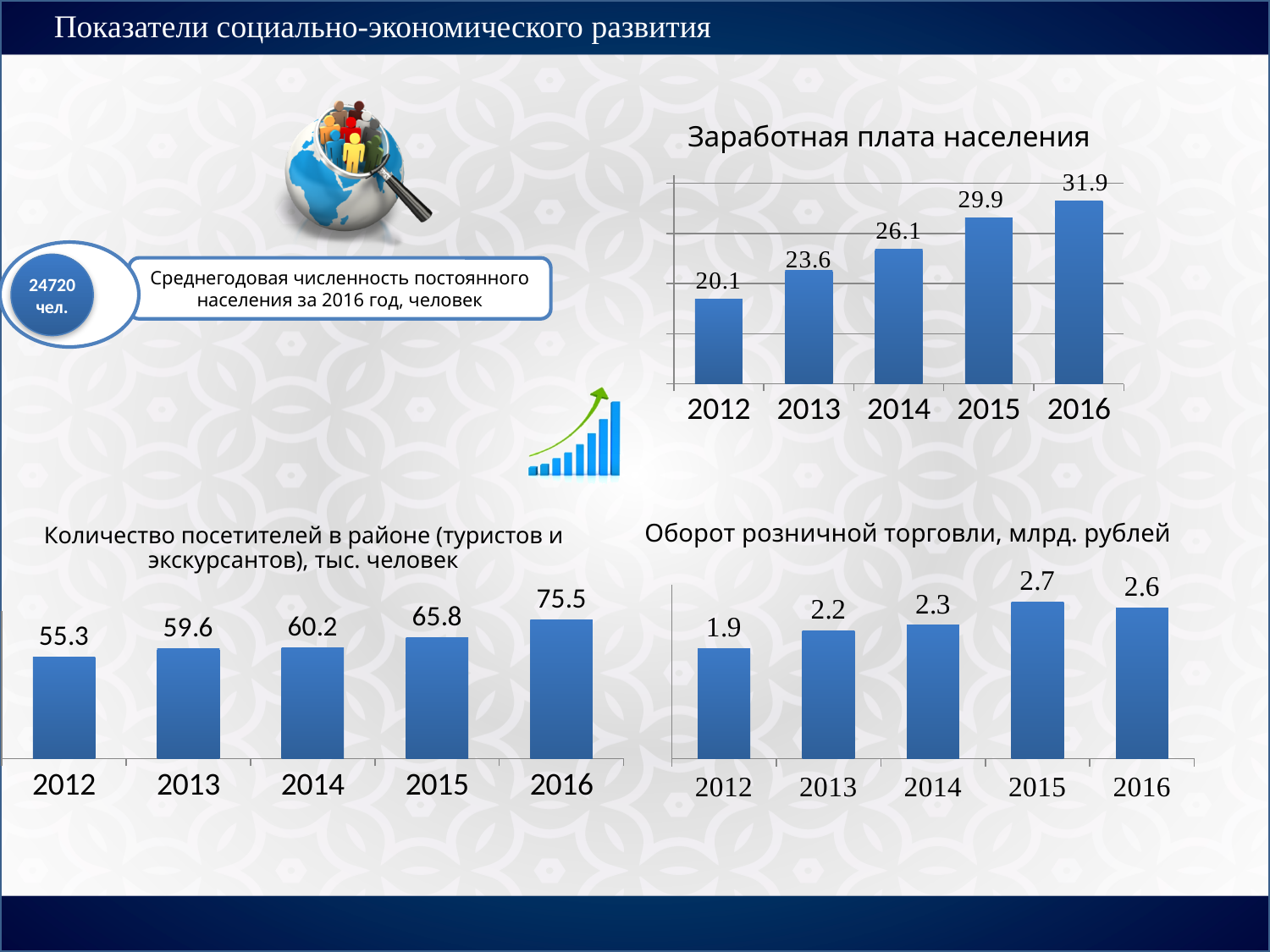
In the chart titled "Количество посетителей в районе (туристов и экскурсантов), тыс. человек", which year has the lowest value? 2012 In the chart titled "Оборот розничной торговли, млрд. рублей", which year has the highest value? 2015 In the chart titled "Количество посетителей в районе (туристов и экскурсантов), тыс. человек", what is the value for 2015? 65.8 In the chart titled "Оборот розничной торговли, млрд. рублей", which is larger, the value for 2015 or the value for 2016? 2015 In the chart titled "Заработная плата населения", what is the difference between the 2016 and 2012 values? 11.8 In the chart titled "Заработная плата населения", what is the value for 2014? 26.1 In the chart titled "Оборот розничной торговли, млрд. рублей", what is the value for 2013? 2.2 In the chart titled "Заработная плата населения", which year has the highest value? 2016 In the chart titled "Количество посетителей в районе (туристов и экскурсантов), тыс. человек", how many years are shown? 5 In the chart titled "Количество посетителей в районе (туристов и экскурсантов), тыс. человек", what is the difference between the 2016 and 2015 values? 9.7 In the chart titled "Заработная плата населения", do the values rise or fall from 2012 to 2016? rise What kind of chart is the chart titled "Заработная плата населения"? bar chart